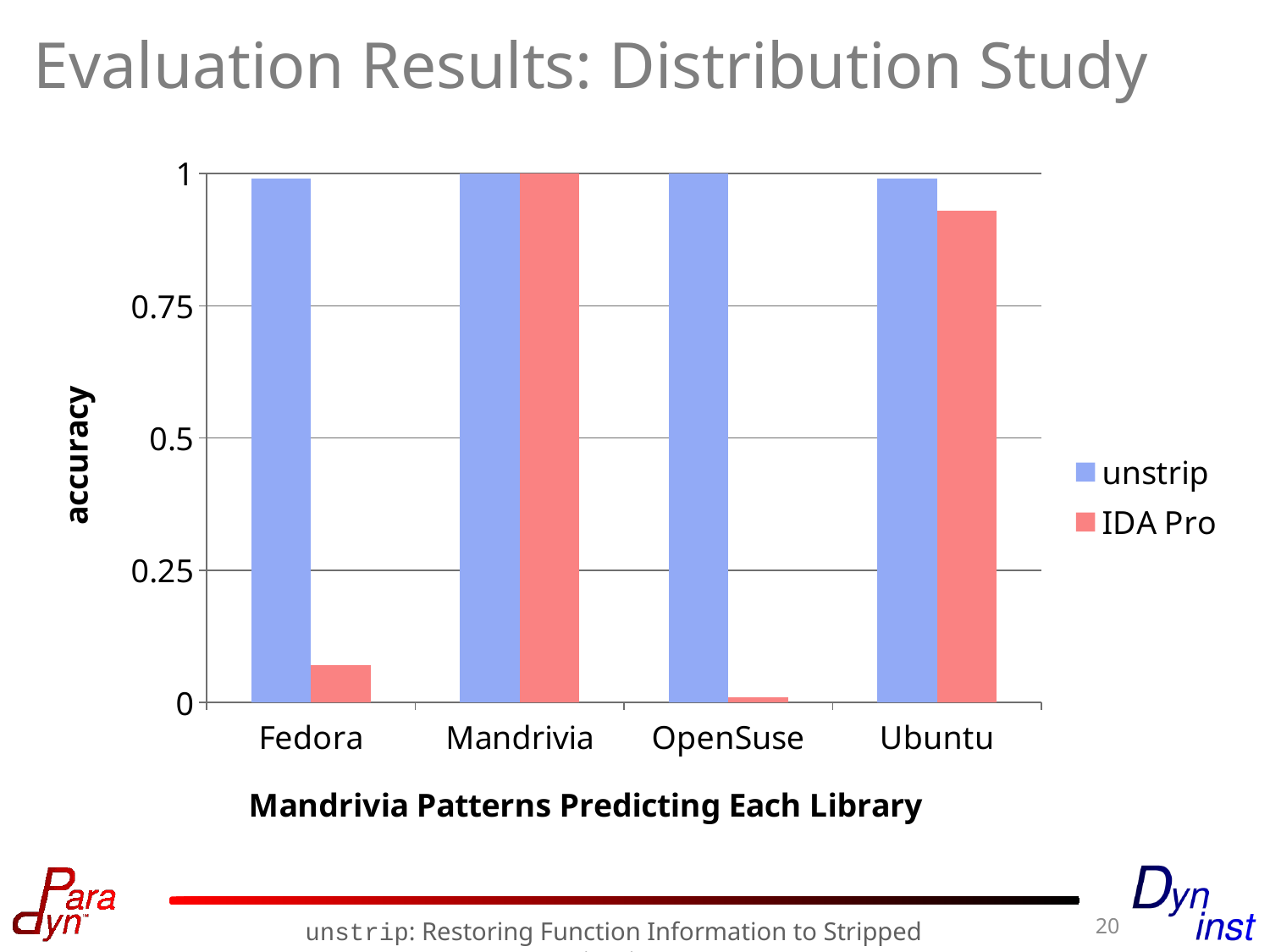
How many series does the legend list? 2 Which colour represents the IDA Pro series in the legend? red What kind of chart is shown on the slide? bar chart Which library has the lowest IDA Pro accuracy? OpenSuse How many library categories are shown on the x axis? 4 Is the IDA Pro accuracy for Fedora greater or less than 0.25? less What is the label on the y axis? accuracy Is the unstrip accuracy for Fedora greater or less than 0.75? greater Is the IDA Pro accuracy for Ubuntu greater or less than 0.75? greater For Fedora, which has the higher accuracy, unstrip or IDA Pro? unstrip What is the accuracy of IDA Pro for Mandrivia? 1 Which library has the highest IDA Pro accuracy? Mandrivia